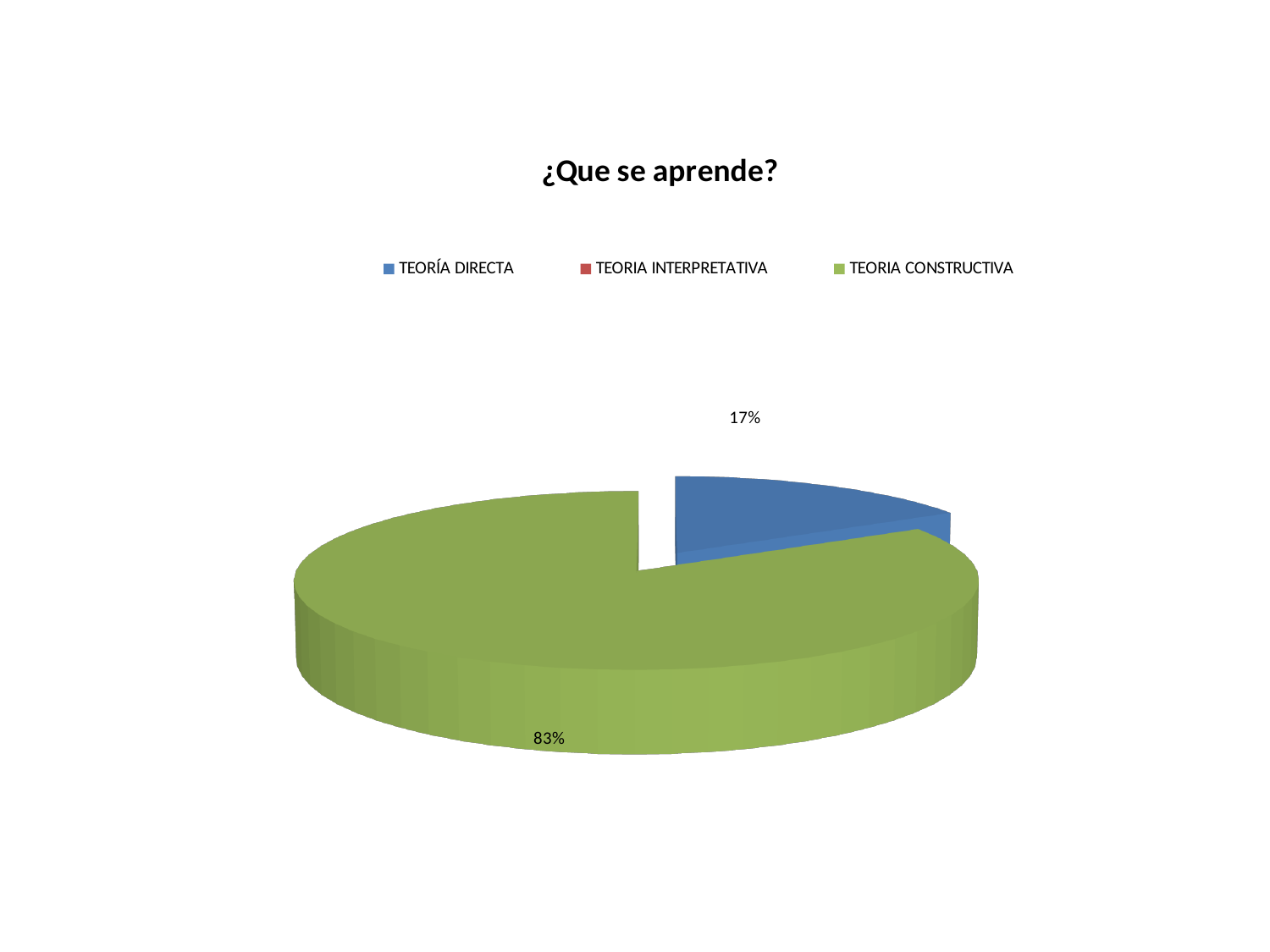
Is the TEORÍA DIRECTA slice larger or smaller than the TEORIA CONSTRUCTIVA slice? Smaller What is the title of the chart? ¿Que se aprende? Which category has the largest slice of the pie? TEORIA CONSTRUCTIVA Which of the two labelled slices is smaller, TEORÍA DIRECTA or TEORIA CONSTRUCTIVA? TEORÍA DIRECTA How many slices of the pie have a percentage label? 2 By how many percentage points does the TEORIA CONSTRUCTIVA slice exceed the TEORÍA DIRECTA slice? 66 percentage points How many entries does the legend list? 3 What share of the pie does the green slice represent? 83% What kind of chart is shown on the slide? Pie chart What colour represents TEORIA CONSTRUCTIVA in the chart? Green What percentage of the pie is labelled for TEORIA CONSTRUCTIVA? 83% What percentage of the pie is labelled for TEORÍA DIRECTA? 17%